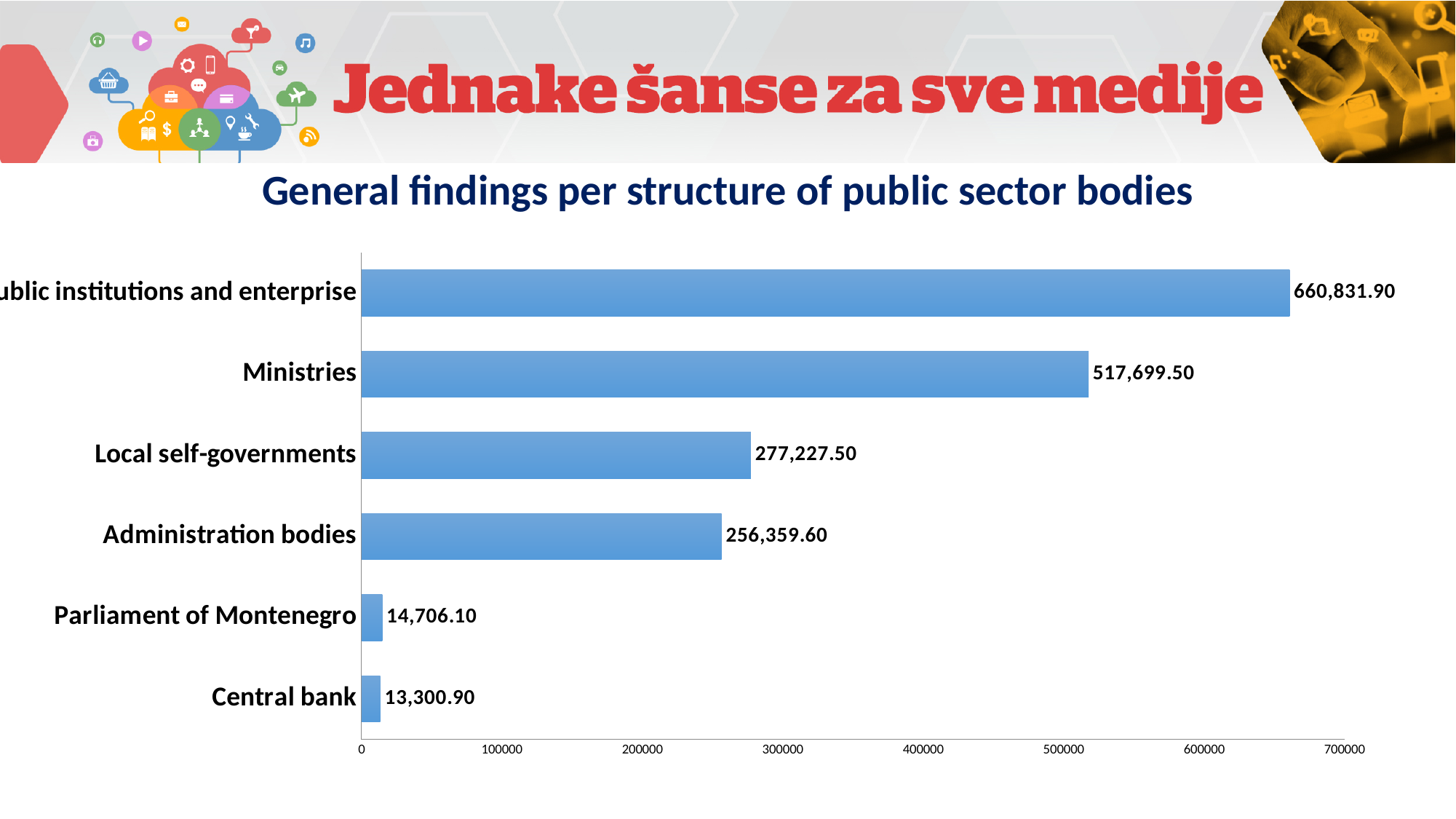
What kind of chart is shown on the slide? bar chart How many categories are shown in the chart? 6 What is the value for Central bank? 13,300.90 What is the difference between the values for Ministries and Local self-governments? 240,472.00 What is the value for Parliament of Montenegro? 14,706.10 What is the value for Administration bodies? 256,359.60 Which category has the lowest value? Central bank What is the value for Local self-governments? 277,227.50 Is the value for Ministries greater or less than 500000? greater Which is larger, the value for Parliament of Montenegro or the value for Central bank? Parliament of Montenegro What is the difference between the values for Local self-governments and Administration bodies? 20,867.90 What is the value for Ministries? 517,699.50